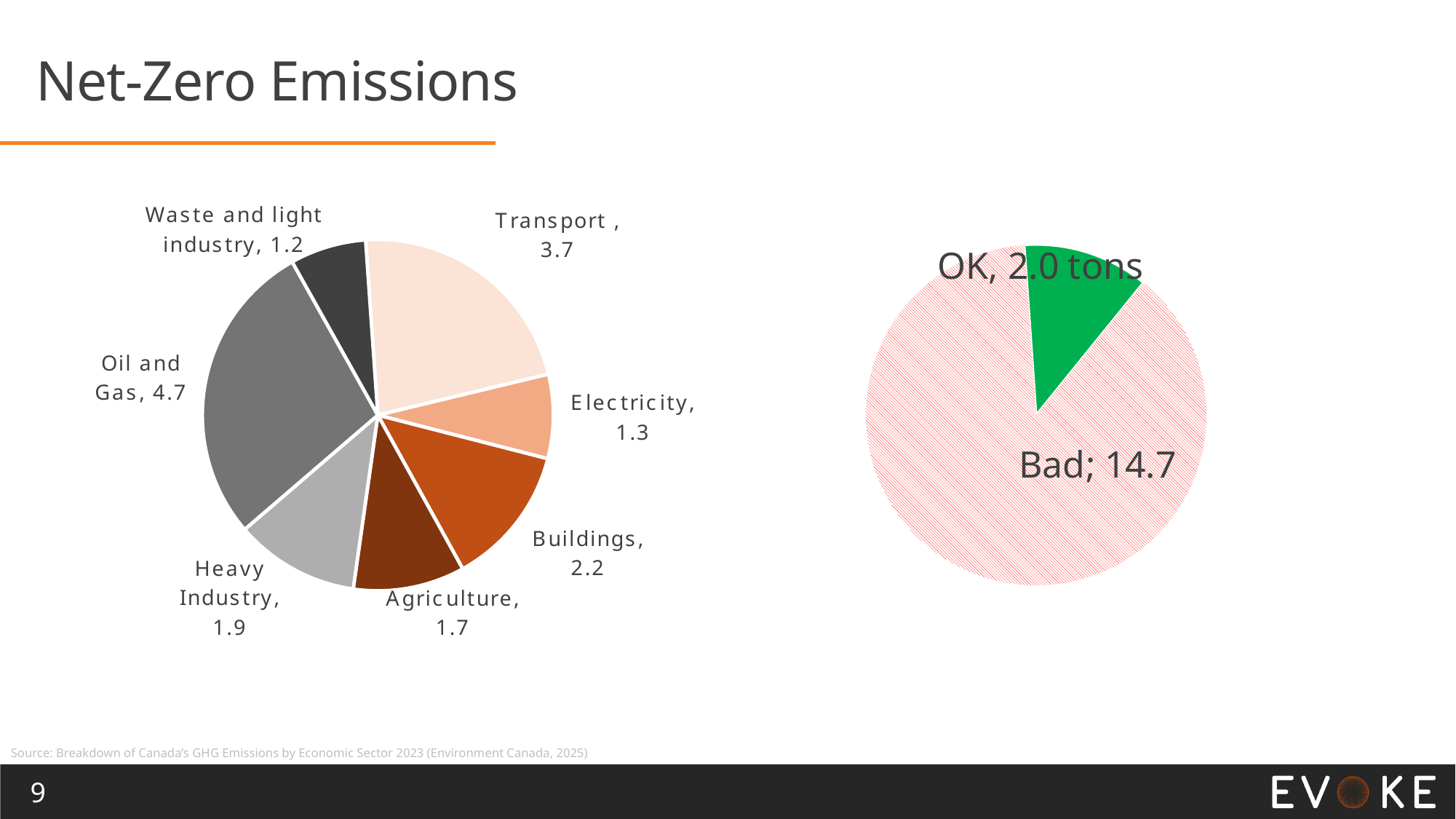
On the right pie chart, what is the value for the Bad slice? 14.7 What type of chart is the chart on the right of the slide? Pie chart On the right pie chart, what is the value for the OK slice? 2.0 tons On the left pie chart, which sector has the largest slice? Oil and Gas On the right pie chart, what colour is the OK slice? Green On the left pie chart, what is the value for Waste and light industry? 1.2 On the left pie chart, what is the value for Transport? 3.7 On the left pie chart, what is the difference between the values for Oil and Gas and Transport? 1.0 How many sectors are shown on the left pie chart? 7 On the left pie chart, which sector has the smallest slice? Waste and light industry On the left pie chart, what is the value for Oil and Gas? 4.7 On the left pie chart, which is larger, Buildings or Heavy Industry? Buildings